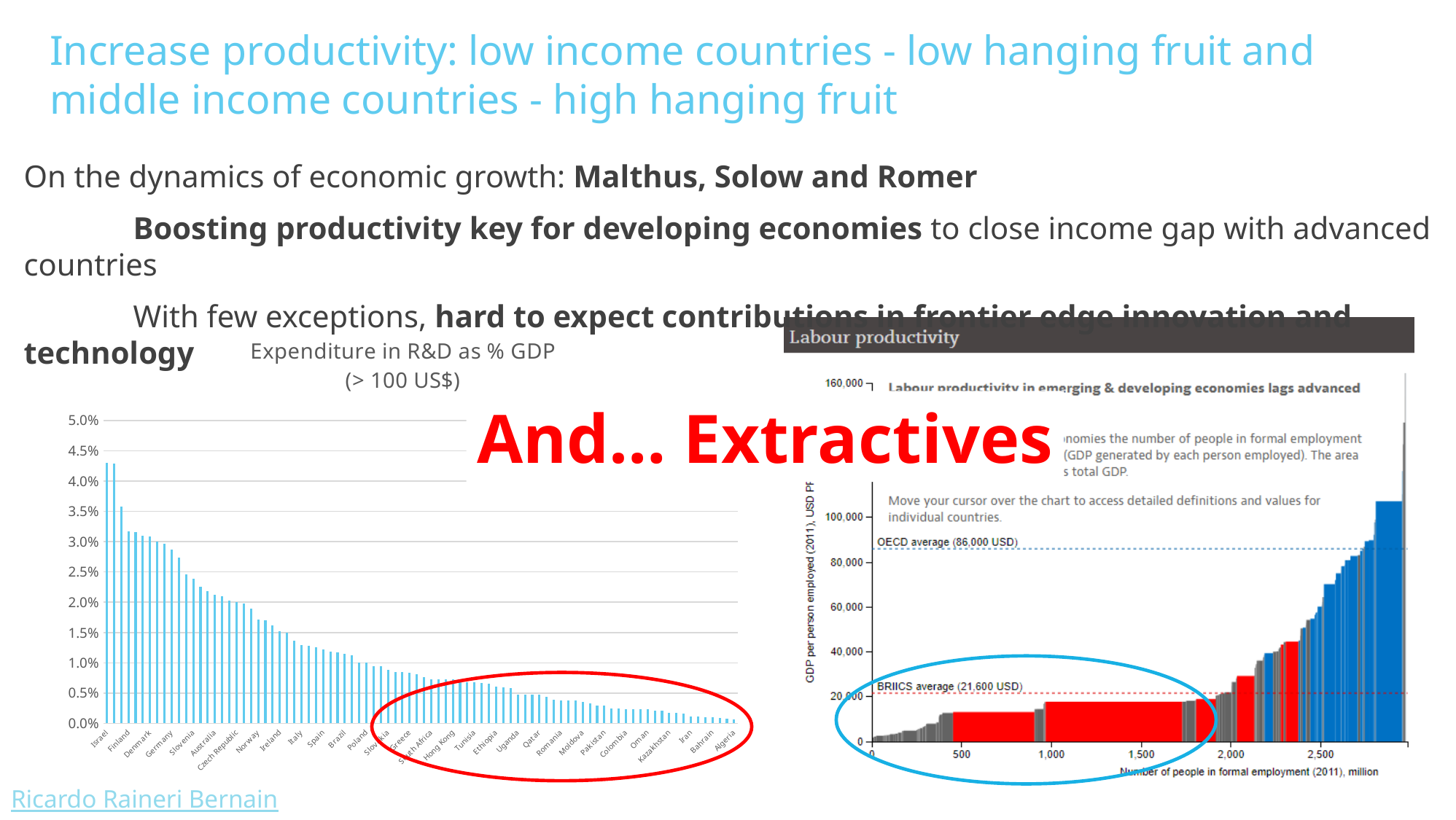
In the 'Labour productivity' chart on the right, what is the OECD average shown? 86,000 USD In the 'Expenditure in R&D as % GDP' chart, is the value for Algeria greater or less than 0.5%? less In the 'Labour productivity' chart on the right, what is the BRIICS average shown? 21,600 USD In the 'Expenditure in R&D as % GDP' chart, which is larger, the value for Israel or the value for Finland? Israel What kind of chart is the 'Expenditure in R&D as % GDP' chart on the left? bar chart In the 'Labour productivity' chart on the right, what is the label of the x axis? Number of people in formal employment (2011), million In the 'Expenditure in R&D as % GDP' chart, which country has the highest value? Israel In the 'Expenditure in R&D as % GDP' chart, is the value for Iran greater or less than 0.5%? less In the 'Expenditure in R&D as % GDP' chart, is the value for Israel greater or less than 4.0%? greater In the 'Labour productivity' chart on the right, what is the difference between the OECD average and the BRIICS average? 64,400 USD In the 'Expenditure in R&D as % GDP' chart, do the values rise or fall from left to right along the x axis? fall